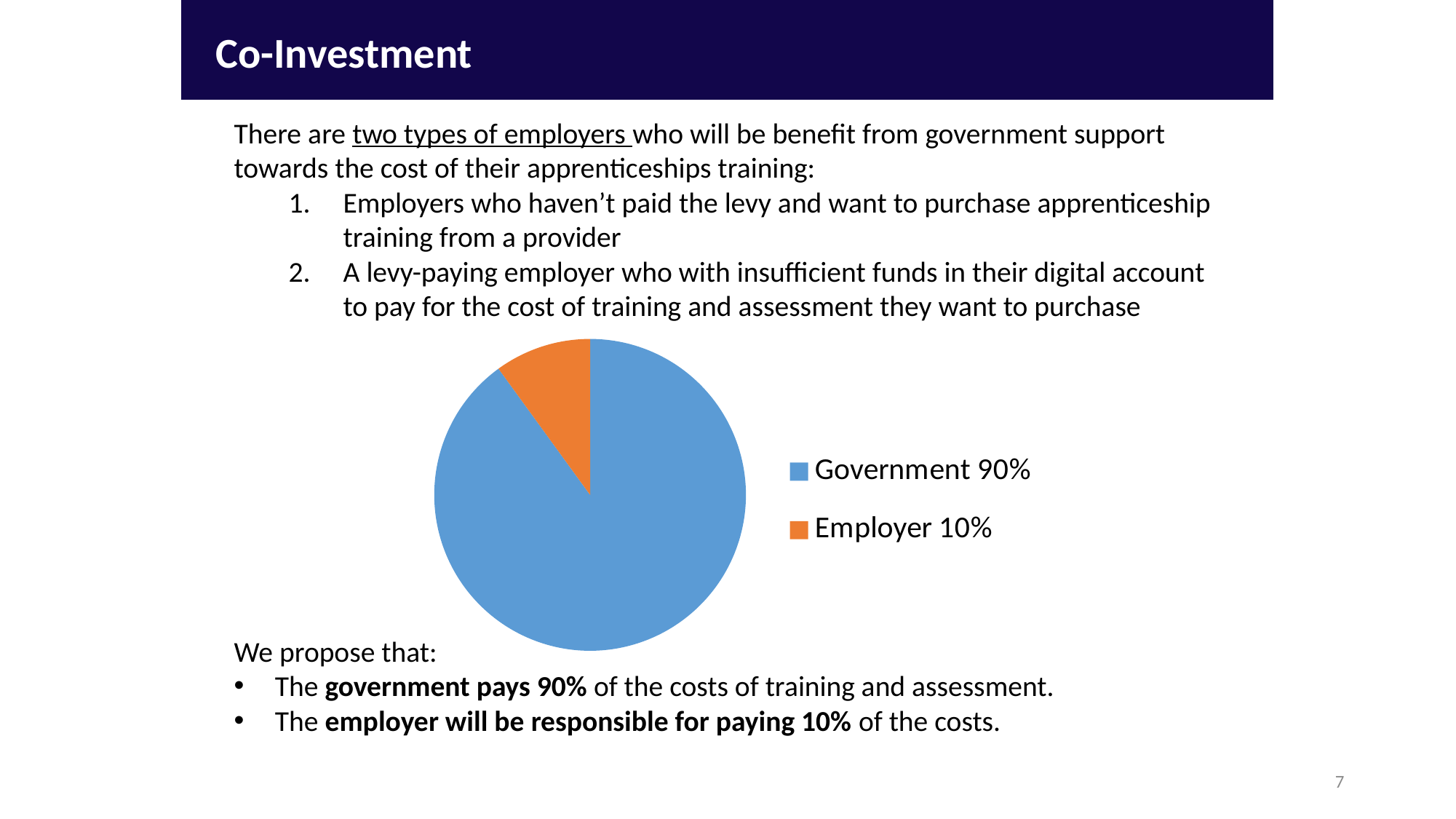
Which is larger in the pie chart, the Government share or the Employer share? Government What kind of chart is shown on the slide? pie chart What colour is the Government slice in the pie chart? blue What share of the pie does the Government slice represent? 90% Which slice of the pie chart is the largest? Government What is the difference between the Government share and the Employer share in the pie chart? 80% How many slices does the pie chart have? 2 What colour is the Employer slice in the pie chart? orange Which slice of the pie chart is the smallest? Employer How many entries does the pie chart's legend list? 2 What share of the pie does the Employer slice represent? 10%